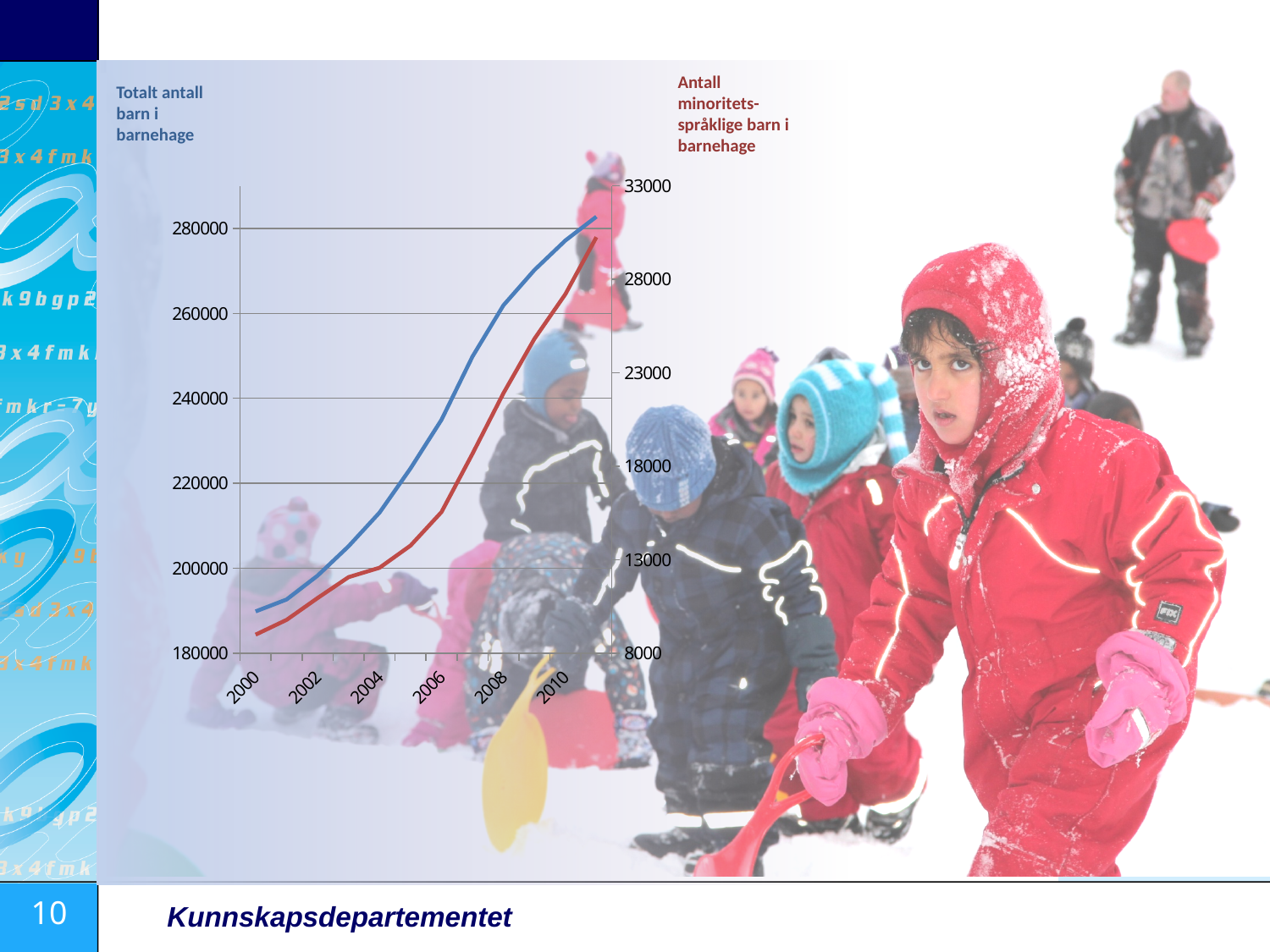
Is the value of the blue line (Totalt antall barn i barnehage) in 2000 greater or less than 200000? less What does the red line represent? Antall minoritetsspråklige barn i barnehage Is the value of the blue line (Totalt antall barn i barnehage) in 2008 greater or less than 240000? greater How many data series are plotted on the chart? 2 Is the value of the red line (Antall minoritetsspråklige barn i barnehage) in 2010 greater or less than 23000? greater Does the total number of children in kindergarten (blue line) rise or fall from 2000 to 2010? rise Does the number of minority-language children in kindergarten (red line) rise or fall over the period shown? rise What kind of chart is shown on the slide? line chart What does the blue line represent? Totalt antall barn i barnehage How many year labels are shown on the x axis? 6